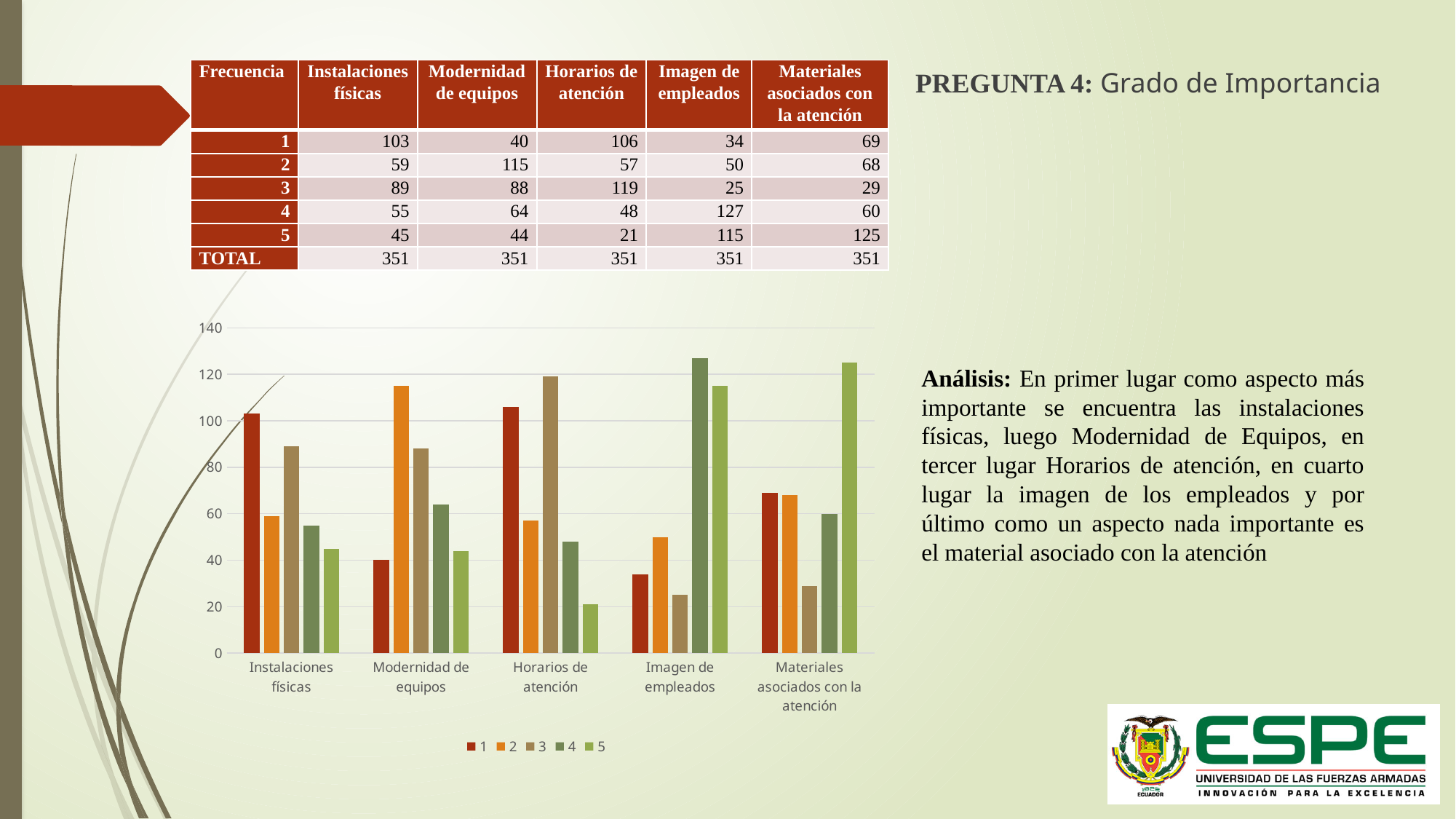
What kind of chart is shown on the slide? bar chart Which category has the highest value for series 2? Modernidad de equipos What is the value of series 5 for Materiales asociados con la atención? 125 How many categories are shown on the x axis of the chart? 5 Is the value of series 4 for Imagen de empleados greater or less than 120? greater How many series does the chart legend list? 5 What is the value of series 1 for Instalaciones físicas? 103 Is the value of series 5 for Horarios de atención greater or less than 40? less Which is larger for Modernidad de equipos: series 2 or series 3? series 2 Which category has the lowest value for series 5? Horarios de atención What is the difference between series 3 and series 5 for Horarios de atención? 98 What is the value of series 4 for Imagen de empleados? 127